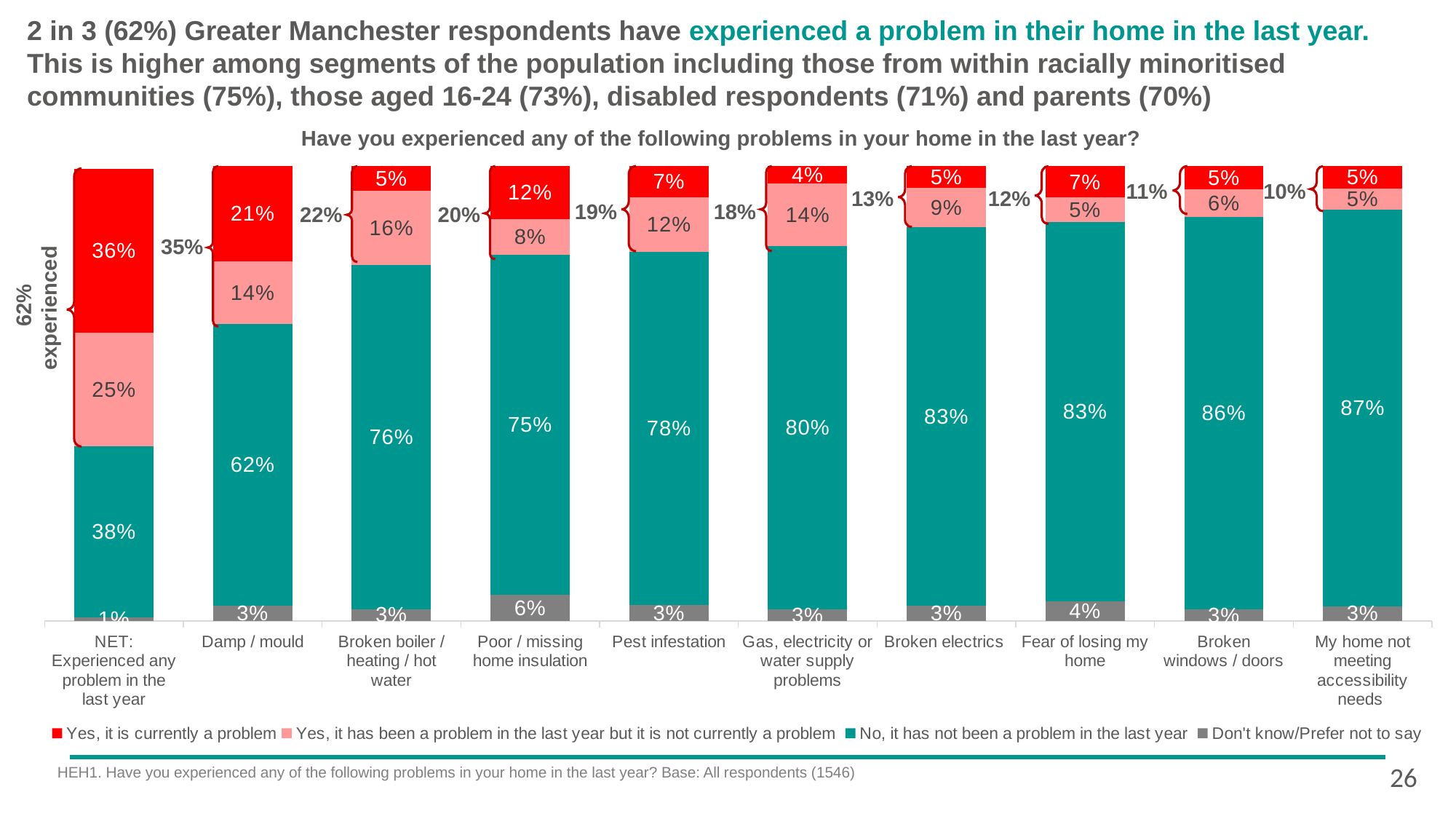
Which is larger: the 'has been a problem in the last year but not currently' percentage for broken boiler / heating / hot water or for broken electrics? Broken boiler / heating / hot water How many problem categories are shown on the x axis of the chart? 10 Which problem has the highest percentage of respondents saying it has not been a problem in the last year? My home not meeting accessibility needs What percentage of respondents answered 'Don't know/Prefer not to say' for poor / missing home insulation? 6% What percentage of respondents said pest infestation has not been a problem in the last year? 78% How many series does the chart legend list? 4 What type of chart is used on this slide? Stacked bar chart Excluding the NET bar, which problem has the highest percentage of respondents saying it is currently a problem? Damp / mould What is the difference between the 'currently a problem' percentages for damp / mould and poor / missing home insulation? 9% What percentage of respondents said damp / mould is currently a problem in their home? 21% What is the combined 'experienced' percentage shown for broken boiler / heating / hot water? 22% Which colour represents 'No, it has not been a problem in the last year' in the chart? Teal